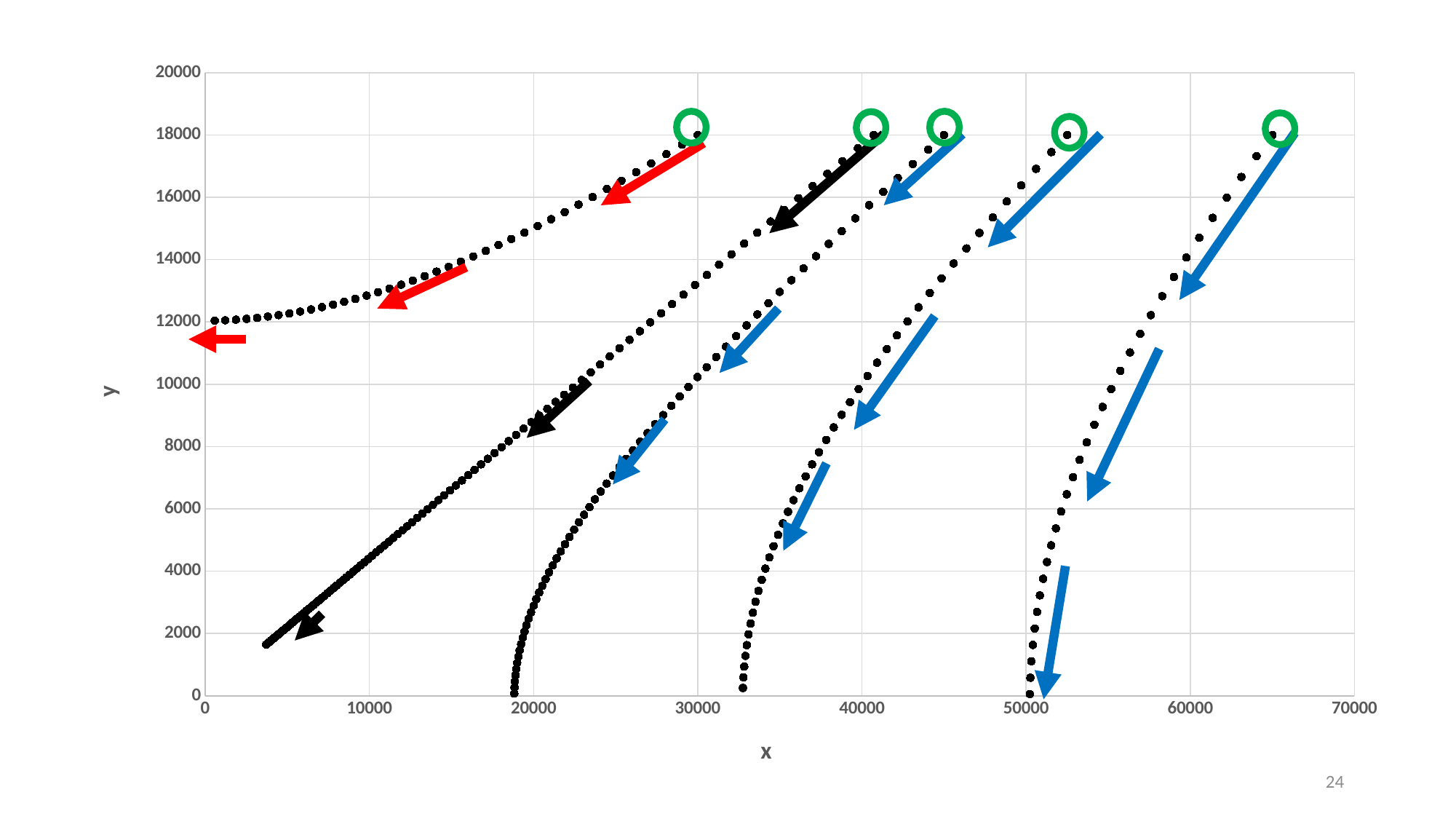
Is the y value at which the green circles are placed greater or less than 16000? greater Is the y value at the left end of the leftmost dotted trajectory greater or less than 10000? greater What is the label of the horizontal axis? x What is the maximum value shown on the x axis? 70000 What kind of chart is shown on the slide? scatter chart Do the y values along each dotted trajectory rise or fall as x decreases from the green circle? fall How many green circles are drawn on the chart? 5 What is the label of the vertical axis? y How many dotted trajectories (curves) are plotted on the chart? 5 Is the x value where the rightmost dotted trajectory reaches y = 0 greater or less than 40000? greater What is the maximum value shown on the y axis? 20000